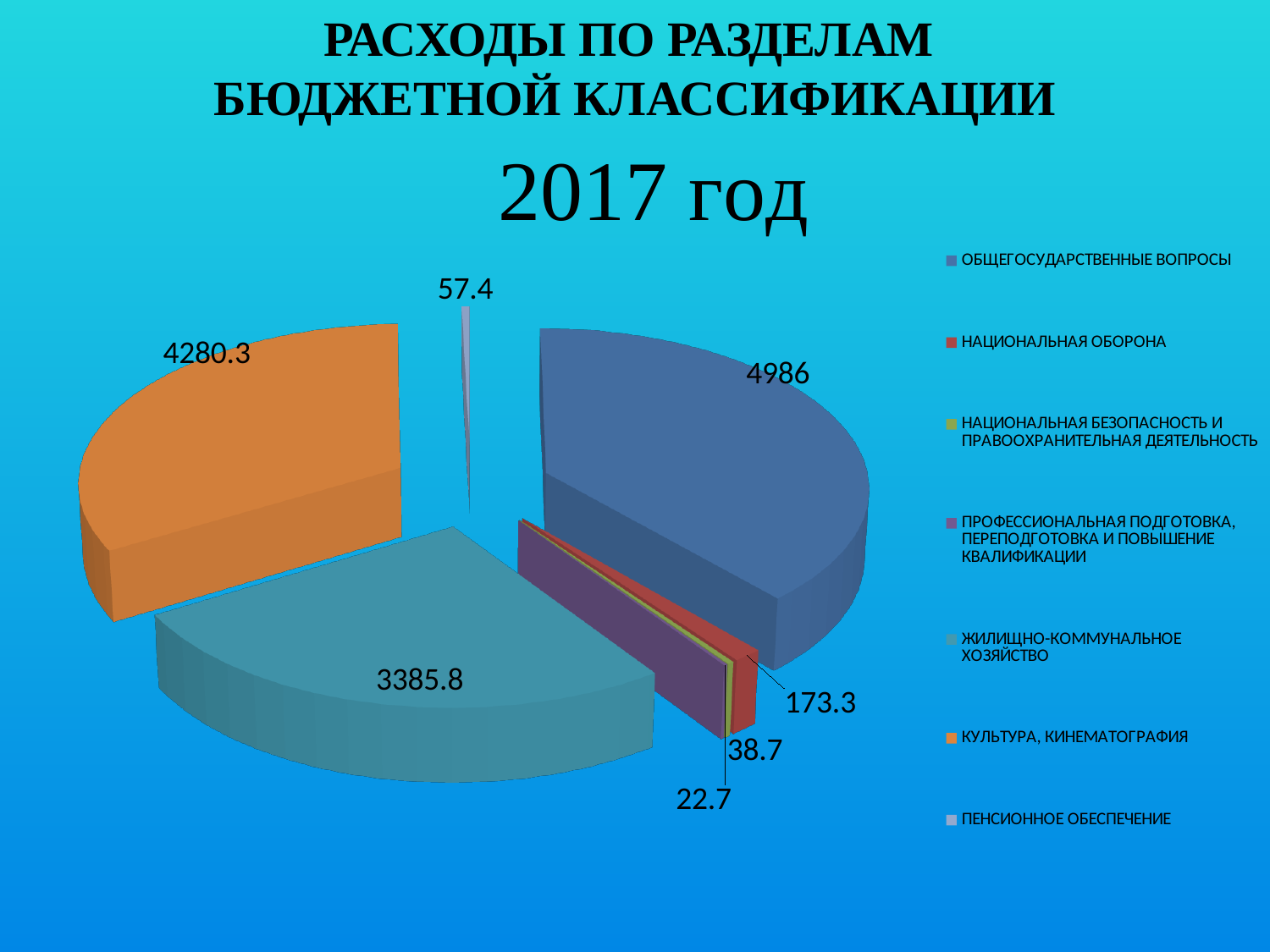
What colour is the slice for КУЛЬТУРА, КИНЕМАТОГРАФИЯ? Orange What is the difference between the values for ОБЩЕГОСУДАРСТВЕННЫЕ ВОПРОСЫ and КУЛЬТУРА, КИНЕМАТОГРАФИЯ? 705.7 What is the value for ЖИЛИЩНО-КОММУНАЛЬНОЕ ХОЗЯЙСТВО? 3385.8 What is the value for ОБЩЕГОСУДАРСТВЕННЫЕ ВОПРОСЫ? 4986 What is the value for КУЛЬТУРА, КИНЕМАТОГРАФИЯ? 4280.3 What type of chart is shown on the slide? Pie chart What year does the chart title refer to? 2017 What is the value for ПЕНСИОННОЕ ОБЕСПЕЧЕНИЕ? 57.4 How many categories does the legend list? 7 What is the value for НАЦИОНАЛЬНАЯ ОБОРОНА? 173.3 Which is larger: КУЛЬТУРА, КИНЕМАТОГРАФИЯ or ЖИЛИЩНО-КОММУНАЛЬНОЕ ХОЗЯЙСТВО? КУЛЬТУРА, КИНЕМАТОГРАФИЯ Which category has the largest value? ОБЩЕГОСУДАРСТВЕННЫЕ ВОПРОСЫ